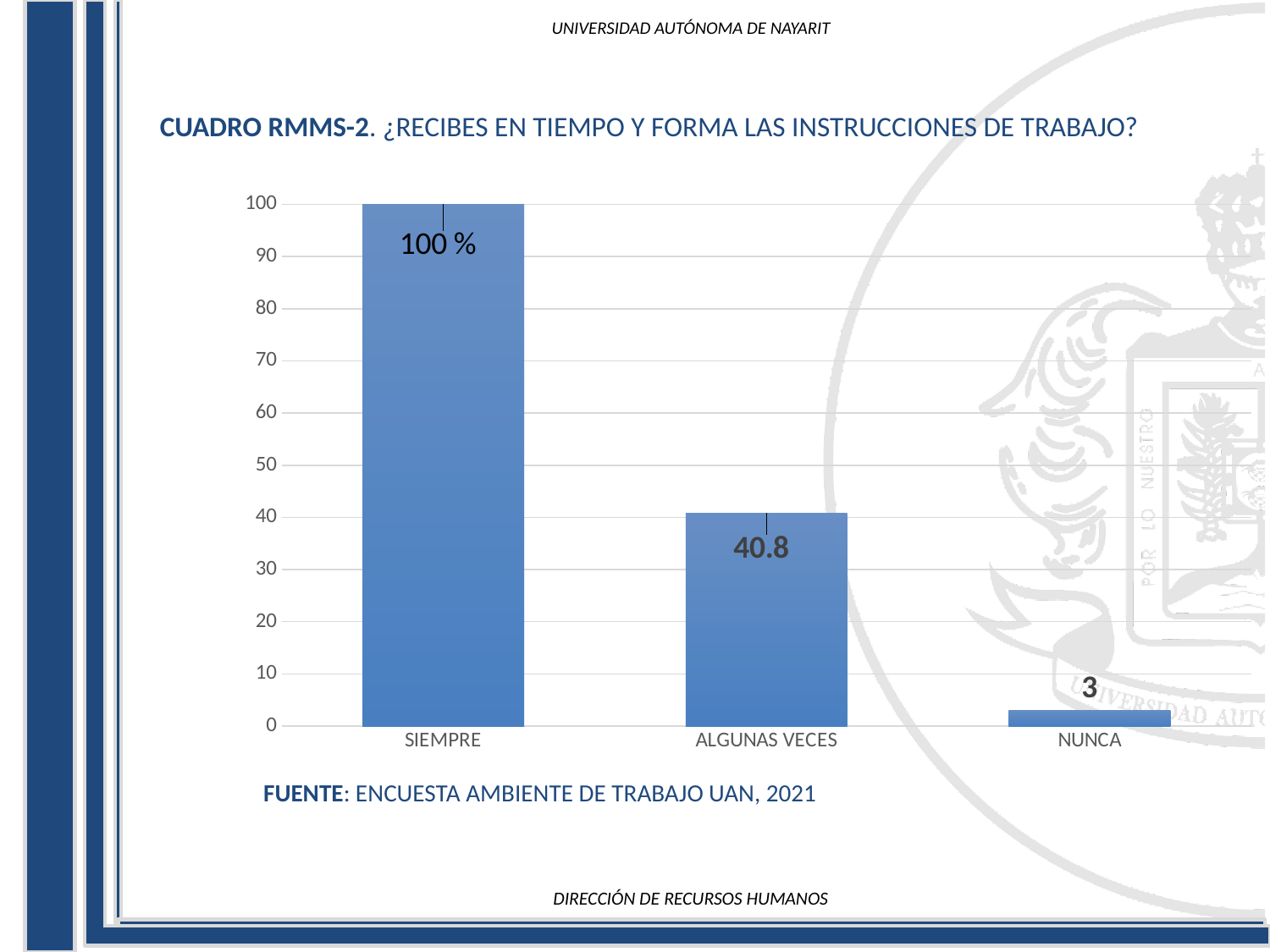
Which is larger, the value for ALGUNAS VECES or the value for NUNCA? ALGUNAS VECES What value is shown for ALGUNAS VECES? 40.8 Which category has the highest value? SIEMPRE Is the value for ALGUNAS VECES greater or less than 50? less Which category has the lowest value? NUNCA What kind of chart is shown on the slide? bar chart How many categories are shown on the x axis? 3 What value is shown for SIEMPRE? 100 % What is the source cited below the chart? ENCUESTA AMBIENTE DE TRABAJO UAN, 2021 What value is shown for NUNCA? 3 Is the value for NUNCA greater or less than 10? less What is the difference between the values for ALGUNAS VECES and NUNCA? 37.8